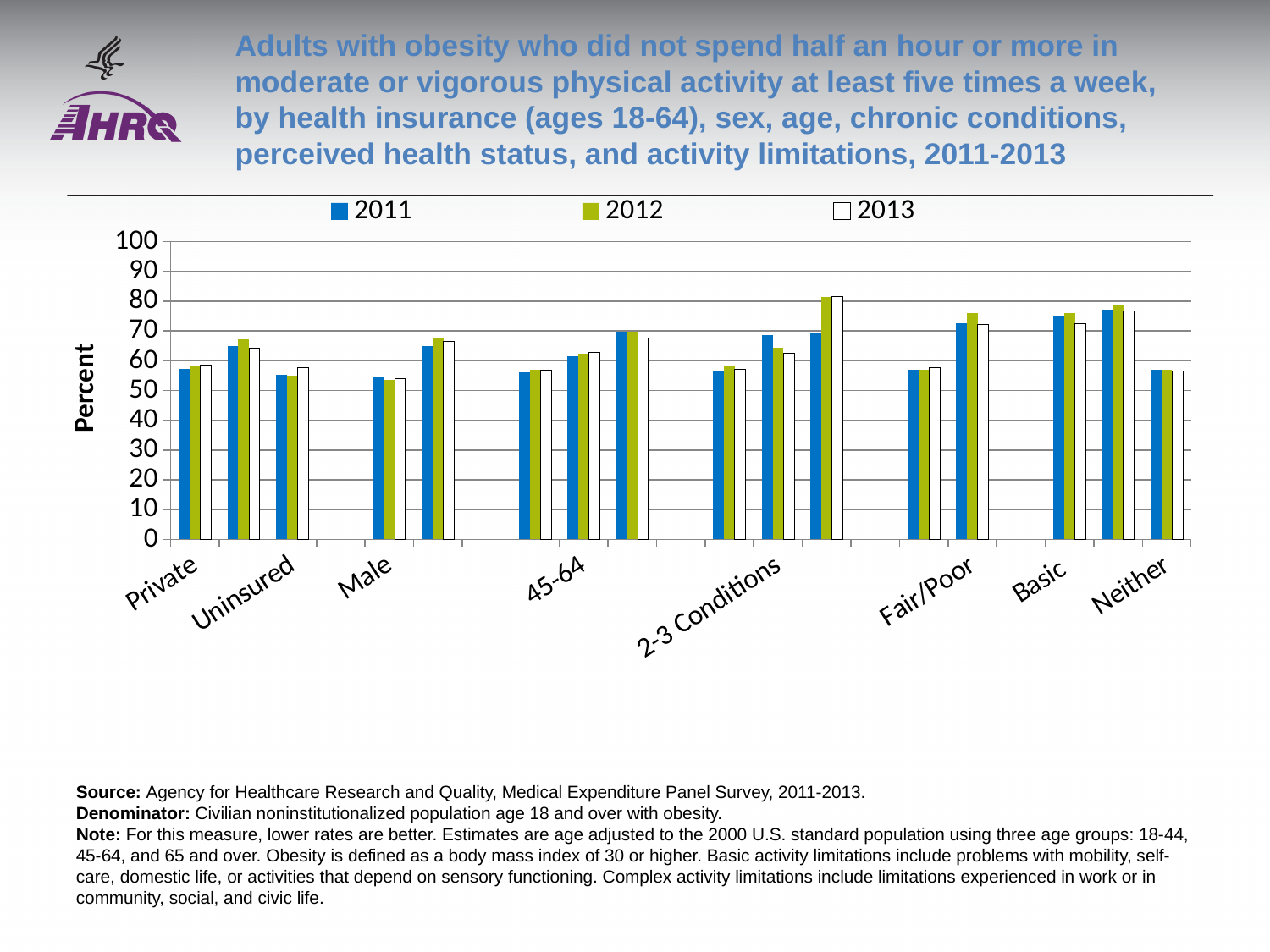
What kind of chart is shown on the slide? bar chart Is the 2011 value for Neither greater or less than 60? less What are the series listed in the legend? 2011, 2012, 2013 Is the 2011 value for Uninsured greater or less than 60? less Which is larger, the 2012 value for Fair/Poor or the 2012 value for Neither? Fair/Poor Is the 2011 value for Male greater or less than 60? less What is the label on the vertical axis? Percent How many series does the legend list? 3